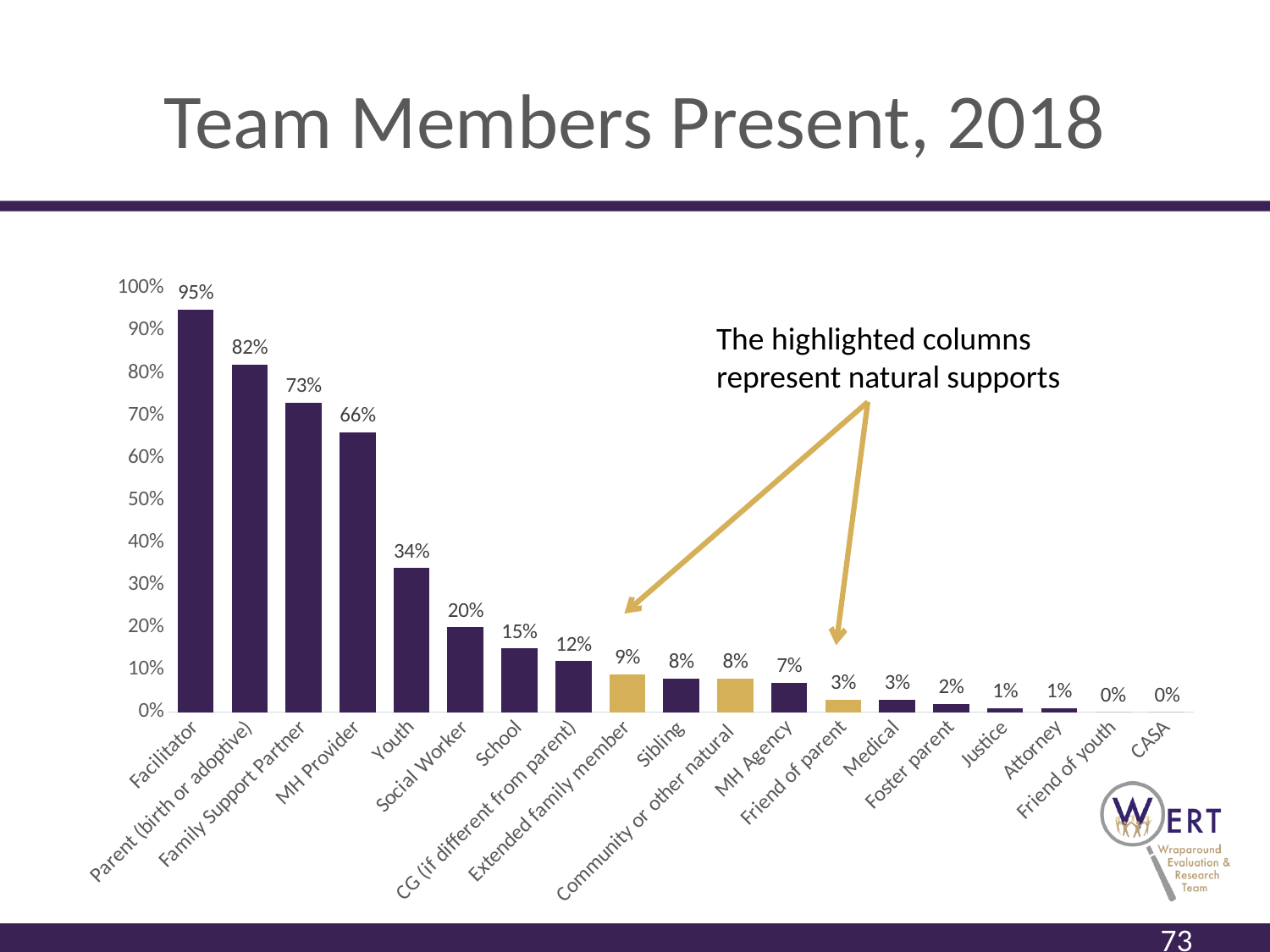
Which team member category has the highest percentage present? Facilitator What is the difference between the values for Parent (birth or adoptive) and MH Provider? 16% What is the difference between the values for Social Worker and School? 5% Is the value for Family Support Partner greater or less than 70%? greater What percentage of teams had a Facilitator present? 95% Which is larger, the value for Sibling or the value for MH Agency? Sibling What is the value for Extended family member? 9% What kind of chart is shown on the slide? Bar chart What is the value for Youth? 34% How many team member categories are shown on the x axis? 19 What is the value for Foster parent? 2% How many columns are highlighted in gold to represent natural supports? 3